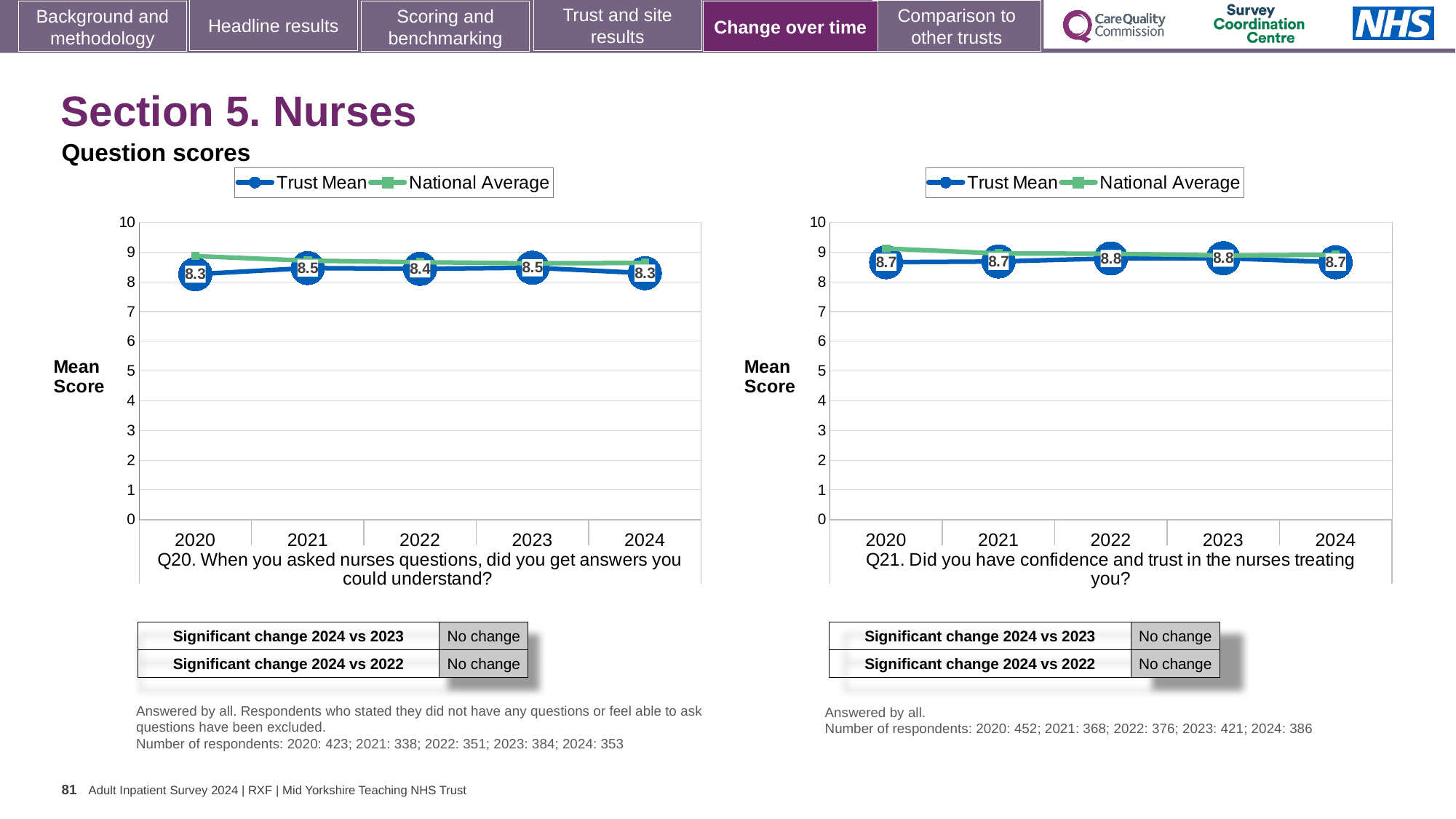
What kind of chart is the Q20 chart on the left? Line chart In the Q20 chart on the left, what is the Trust Mean score for 2023? 8.5 What are the two series named in the legend of the Q20 chart on the left? Trust Mean and National Average In the Q21 chart on the right, what is the difference between the Trust Mean scores for 2023 and 2020? 0.1 In the Q21 chart on the right, what is the Trust Mean score for 2022? 8.8 How many series does the legend of the Q21 chart on the right list? 2 In the Q21 chart on the right, is the National Average value for 2020 greater or less than 8? greater In the Q21 chart on the right, what is the Trust Mean score for 2024? 8.7 In the Q20 chart on the left, which year has the higher Trust Mean score, 2020 or 2021? 2021 In the Q20 chart on the left, what is the Trust Mean score for 2020? 8.3 In the Q20 chart on the left, what is the difference between the Trust Mean scores for 2021 and 2024? 0.2 How many years are plotted on the x axis of the Q20 chart on the left? 5